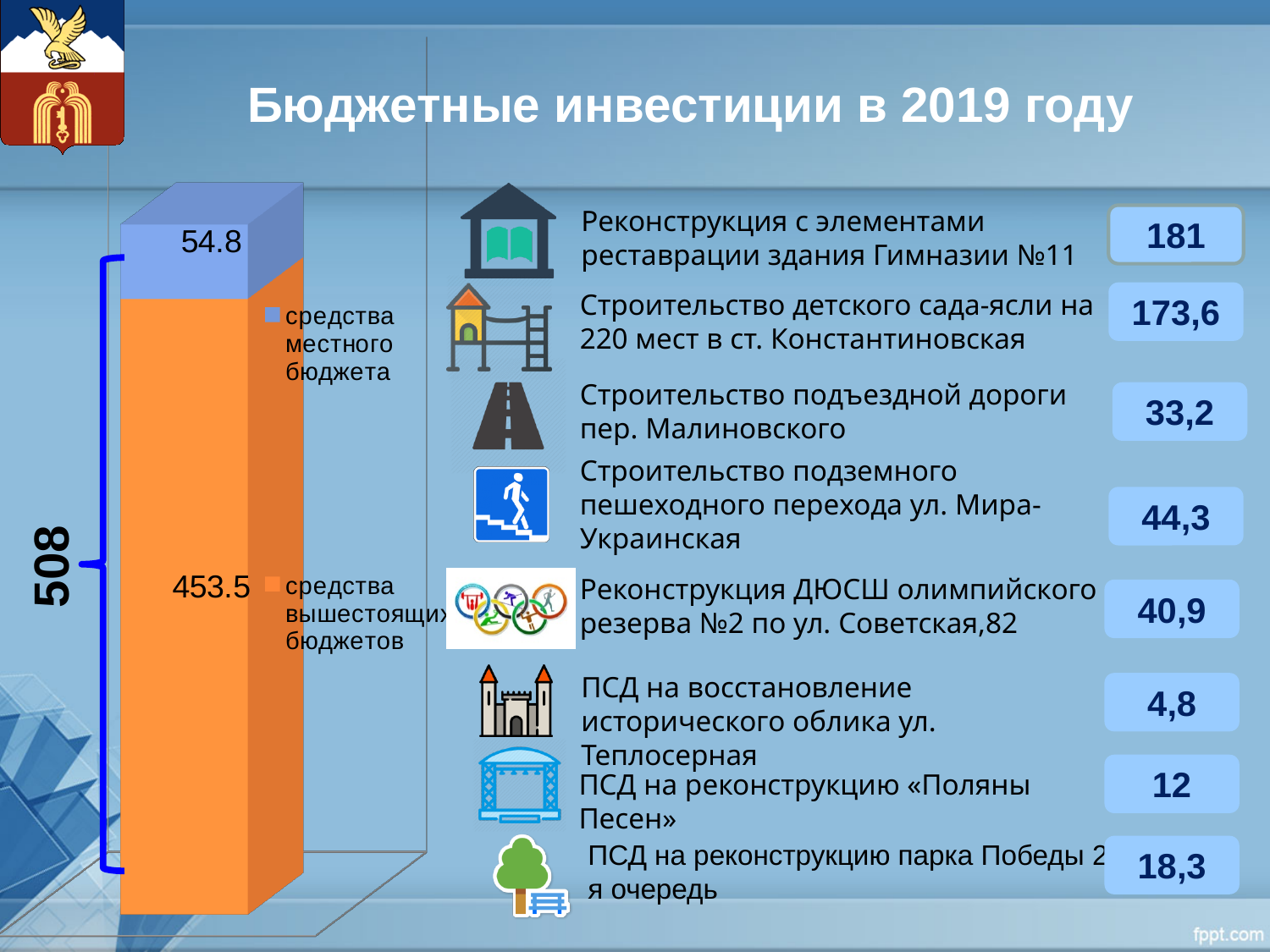
How many bars does the chart contain? 1 Which series has the largest value in the stacked bar? средства вышестоящих бюджетов How many series does the chart legend list? 2 What colour is the segment for средства местного бюджета? blue Which series has the smallest value in the stacked bar? средства местного бюджета What is the value of the segment labelled "средства вышестоящих бюджетов" in the stacked bar? 453.5 What kind of chart is shown on the left of the slide? stacked bar chart Which segment of the stacked bar is larger: средства местного бюджета or средства вышестоящих бюджетов? средства вышестоящих бюджетов What is the difference between the two segments of the stacked bar (453.5 and 54.8)? 398.7 What is the value of the segment labelled "средства местного бюджета" in the stacked bar? 54.8 What colour is the segment for средства вышестоящих бюджетов? orange What is the total of the stacked bar, as shown by the bracket label on the slide? 508